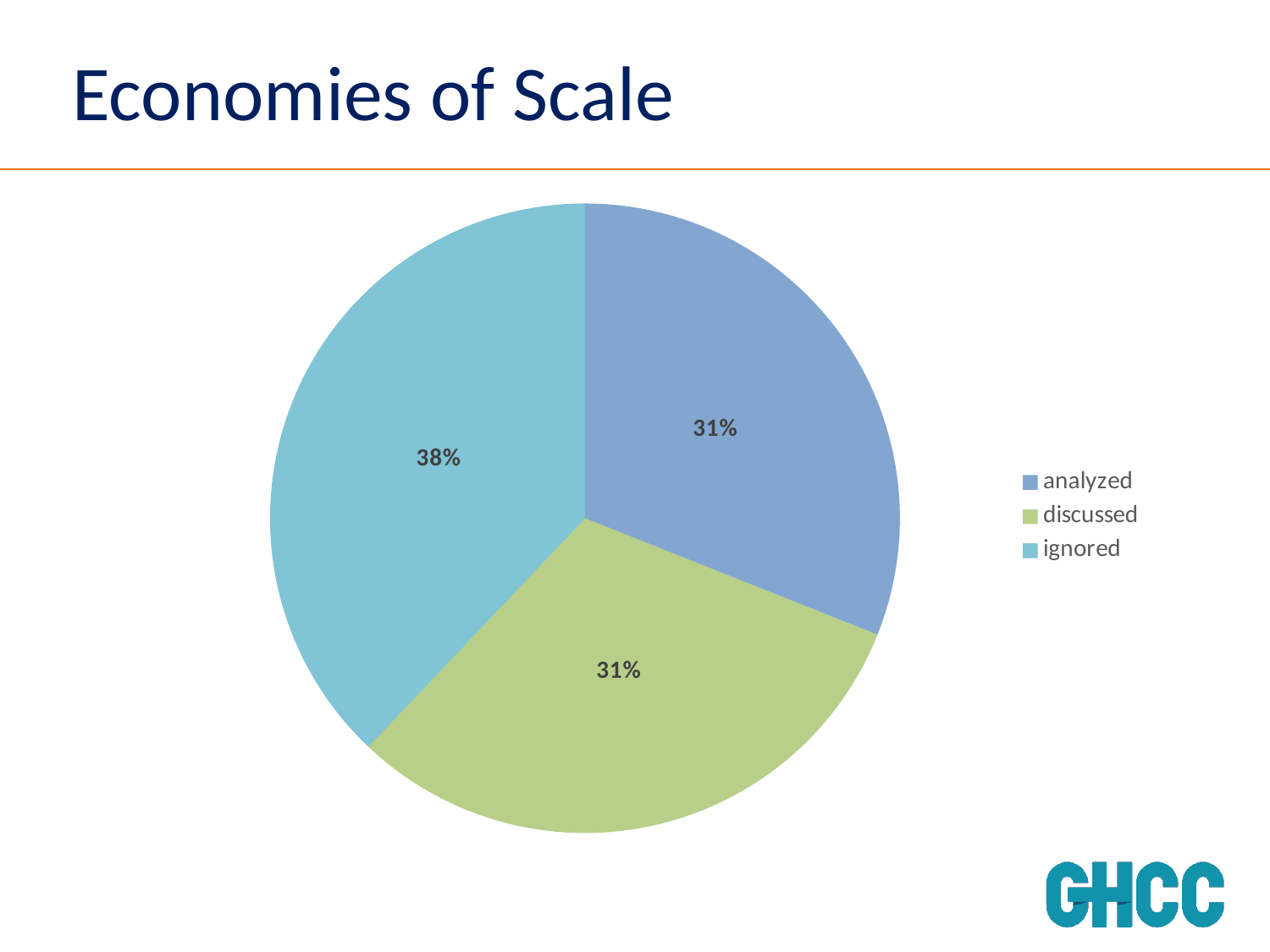
What is the difference in percentage points between the "ignored" slice and the "analyzed" slice? 7 Which is larger, the "ignored" slice or the "discussed" slice? ignored Which category is shown in green in the pie chart? discussed How many slices does the pie chart have? 3 What share of the pie is labelled "analyzed"? 31% What kind of chart is shown on the slide? pie chart What share of the pie is labelled "ignored"? 38% What is the title of the slide containing the pie chart? Economies of Scale How many entries does the legend list? 3 What share of the pie is labelled "discussed"? 31% Which category has the largest slice of the pie? ignored